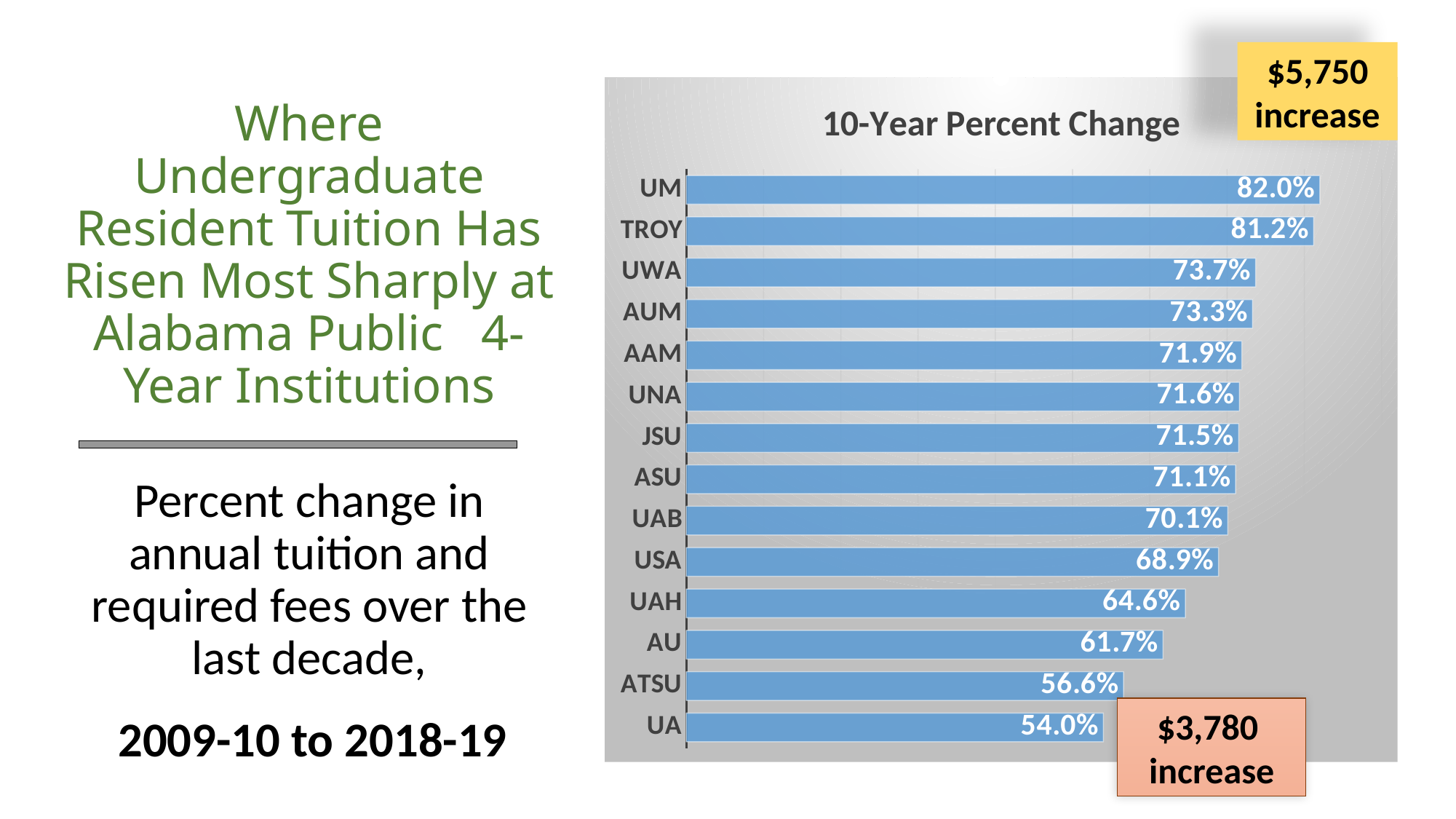
Which institution has the lowest 10-year percent change? UA What is the title of the chart? 10-Year Percent Change What is the difference in percentage points between UM and UA? 28.0 What is the difference in percentage points between UWA and AUM? 0.4 What is the 10-year percent change for UAB? 70.1% Which institution has the highest 10-year percent change? UM What kind of chart is shown on the slide? Bar chart Which has a larger 10-year percent change, UAH or AU? UAH What is the 10-year percent change for UM? 82.0% Which has a larger 10-year percent change, USA or TROY? TROY How many institutions are shown in the chart? 14 What is the 10-year percent change for ATSU? 56.6%